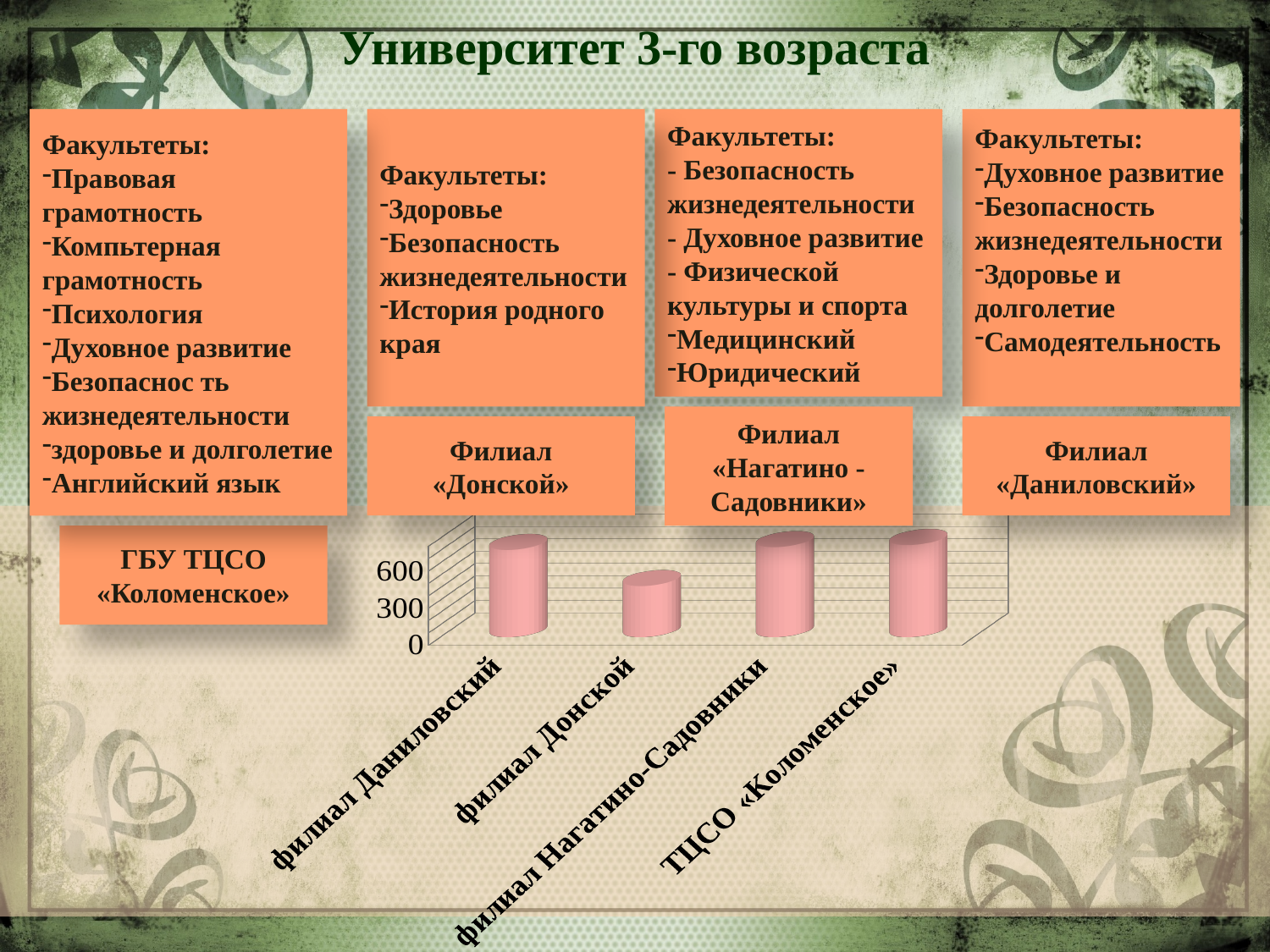
Which category has the lowest value on the chart? филиал Донской How many categories are plotted on the chart? 4 Is the value for филиал Нагатино-Садовники greater or less than 600? greater Is the value for филиал Даниловский greater or less than 600? greater What colour are the bars on the chart? pink Which is larger, the value for филиал Даниловский or the value for филиал Донской? филиал Даниловский Is the value for филиал Донской greater or less than 600? less What is the highest tick value shown on the vertical axis of the chart? 600 Which is larger, the value for филиал Донской or the value for ТЦСО «Коломенское»? ТЦСО «Коломенское» What kind of chart is shown on the slide? bar chart